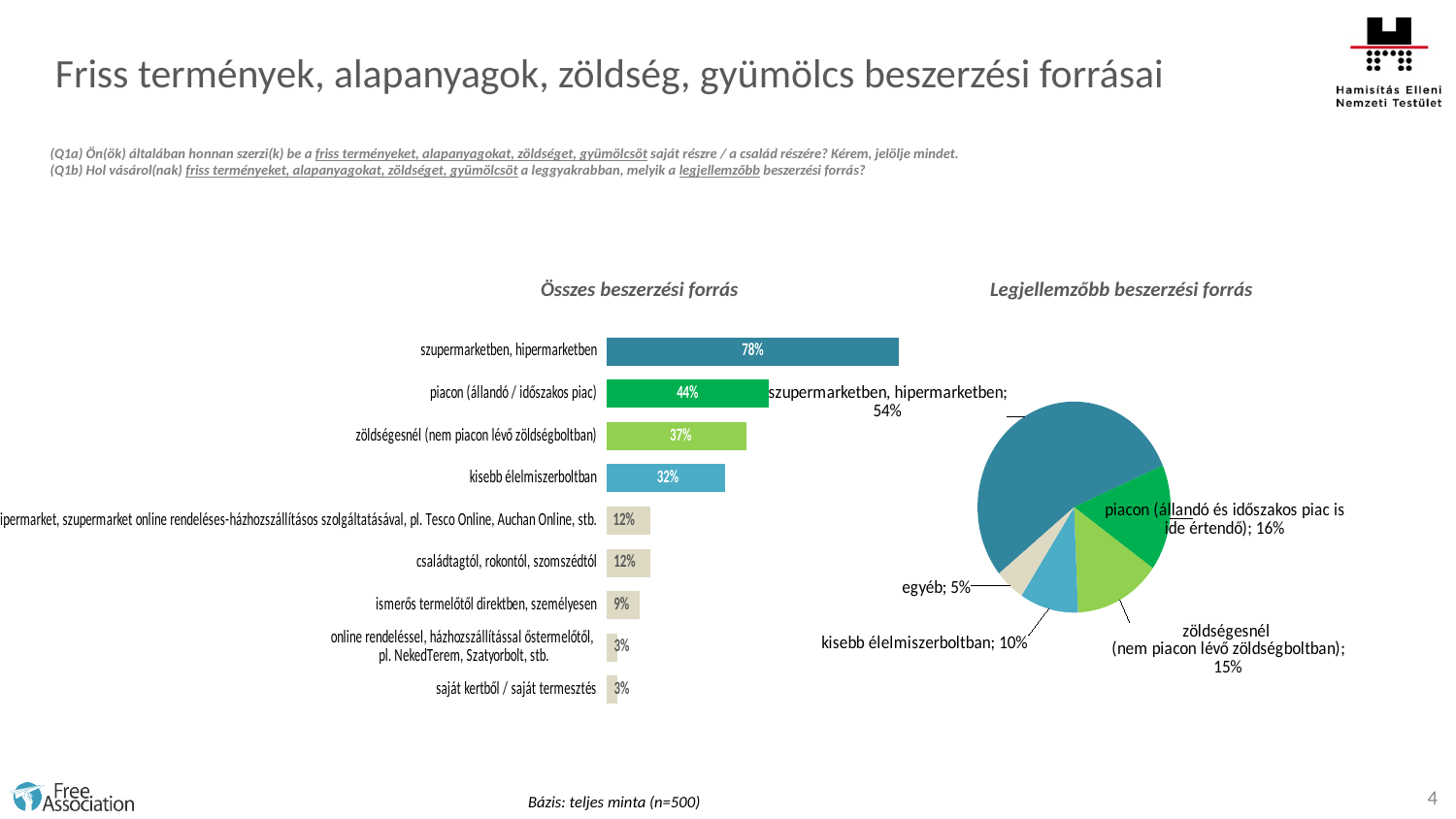
How many categories are shown in the 'Összes beszerzési forrás' chart? 9 In the 'Összes beszerzési forrás' chart, which category has the highest value? szupermarketben, hipermarketben In the 'Összes beszerzési forrás' chart, what is the value for 'kisebb élelmiszerboltban'? 32% In the 'Összes beszerzési forrás' chart, what is the difference between 'piacon (állandó / időszakos piac)' and 'zöldségesnél (nem piacon lévő zöldségboltban)'? 7% What kind of chart is 'Összes beszerzési forrás'? bar chart How many slices does the 'Legjellemzőbb beszerzési forrás' pie chart have? 5 In the 'Összes beszerzési forrás' chart, which is larger: 'kisebb élelmiszerboltban' or 'családtagtól, rokontól, szomszédtól'? kisebb élelmiszerboltban In the 'Legjellemzőbb beszerzési forrás' pie chart, which slice is the smallest? egyéb What kind of chart is 'Legjellemzőbb beszerzési forrás'? pie chart In the 'Legjellemzőbb beszerzési forrás' pie chart, what is the value for 'egyéb'? 5% In the 'Összes beszerzési forrás' chart, what is the value for 'szupermarketben, hipermarketben'? 78% In the 'Legjellemzőbb beszerzési forrás' pie chart, what share does 'szupermarketben, hipermarketben' have? 54%